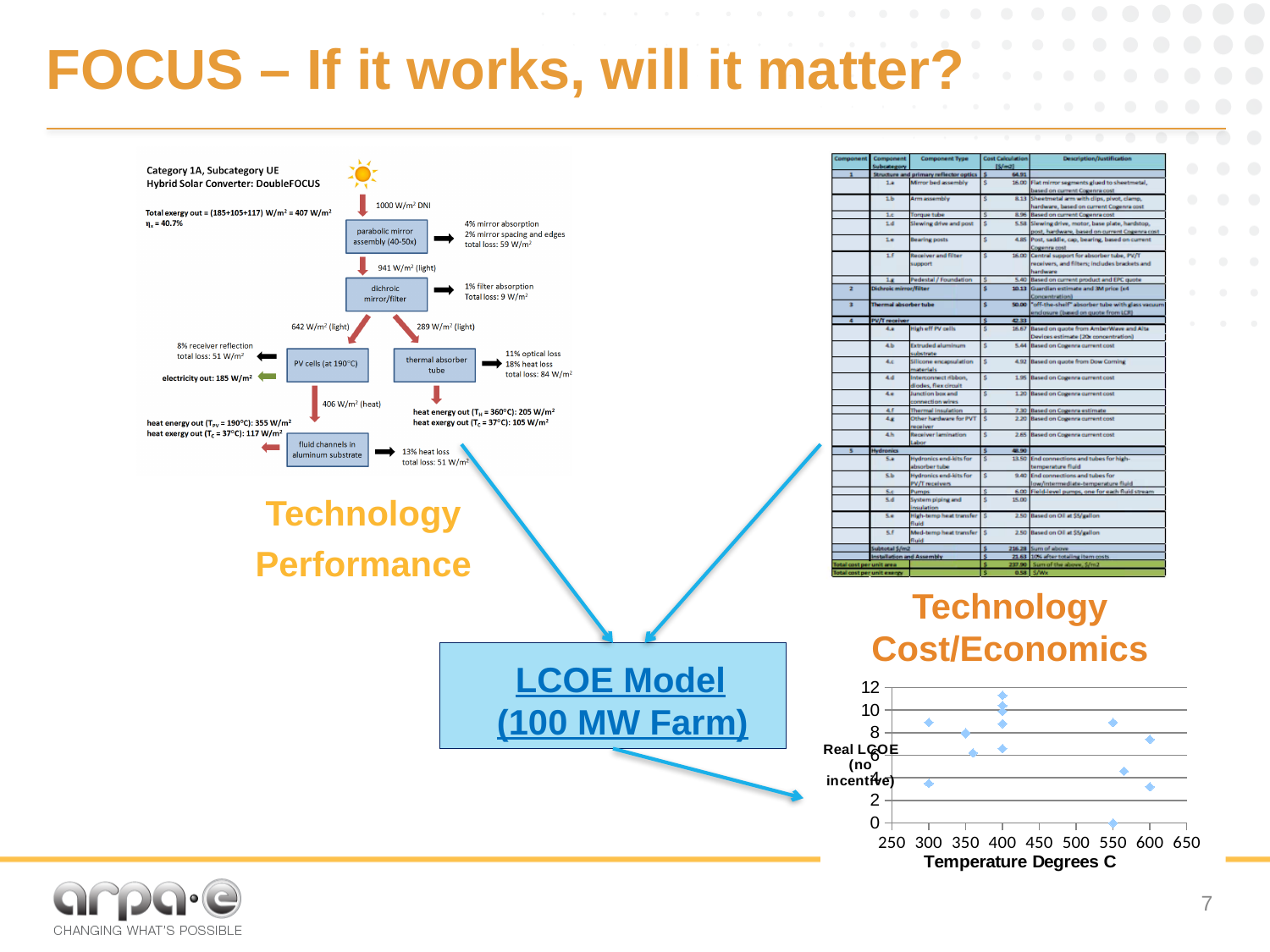
What kind of chart is shown at the bottom right of the slide, plotting Real LCOE against Temperature Degrees C? scatter chart In the Real LCOE chart, is the highest plotted point greater or less than 10? greater In the Real LCOE chart, is the lowest plotted point greater or less than 2? less In the chart at the bottom right, what is the label of the y axis? Real LCOE (no incentive) In the Real LCOE chart, is the highest point plotted near 400 degrees C greater or less than 10? greater In the chart at the bottom right, what is the label of the x axis? Temperature Degrees C